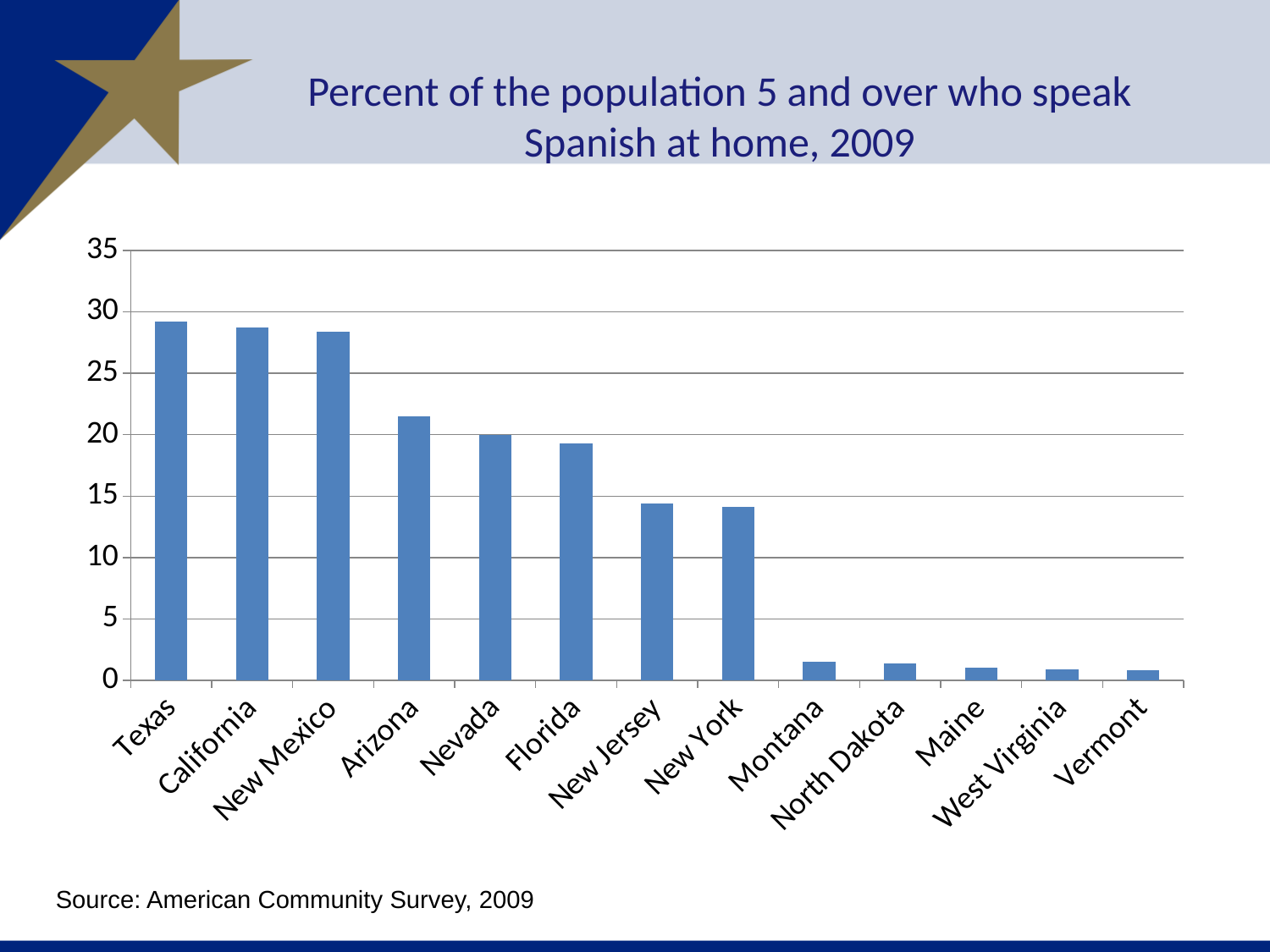
Is the value for New Jersey greater or less than 15? less Is the value for New York greater or less than 10? greater Is the value for Texas greater or less than 25? greater Which has a larger value, New Jersey or Montana? New Jersey What is the source cited for the chart's data? American Community Survey, 2009 What kind of chart is shown on the slide? bar chart Do the values rise or fall moving from left to right along the x axis? fall How many states are shown on the x axis of the chart? 13 Which has a larger value, Arizona or Florida? Arizona